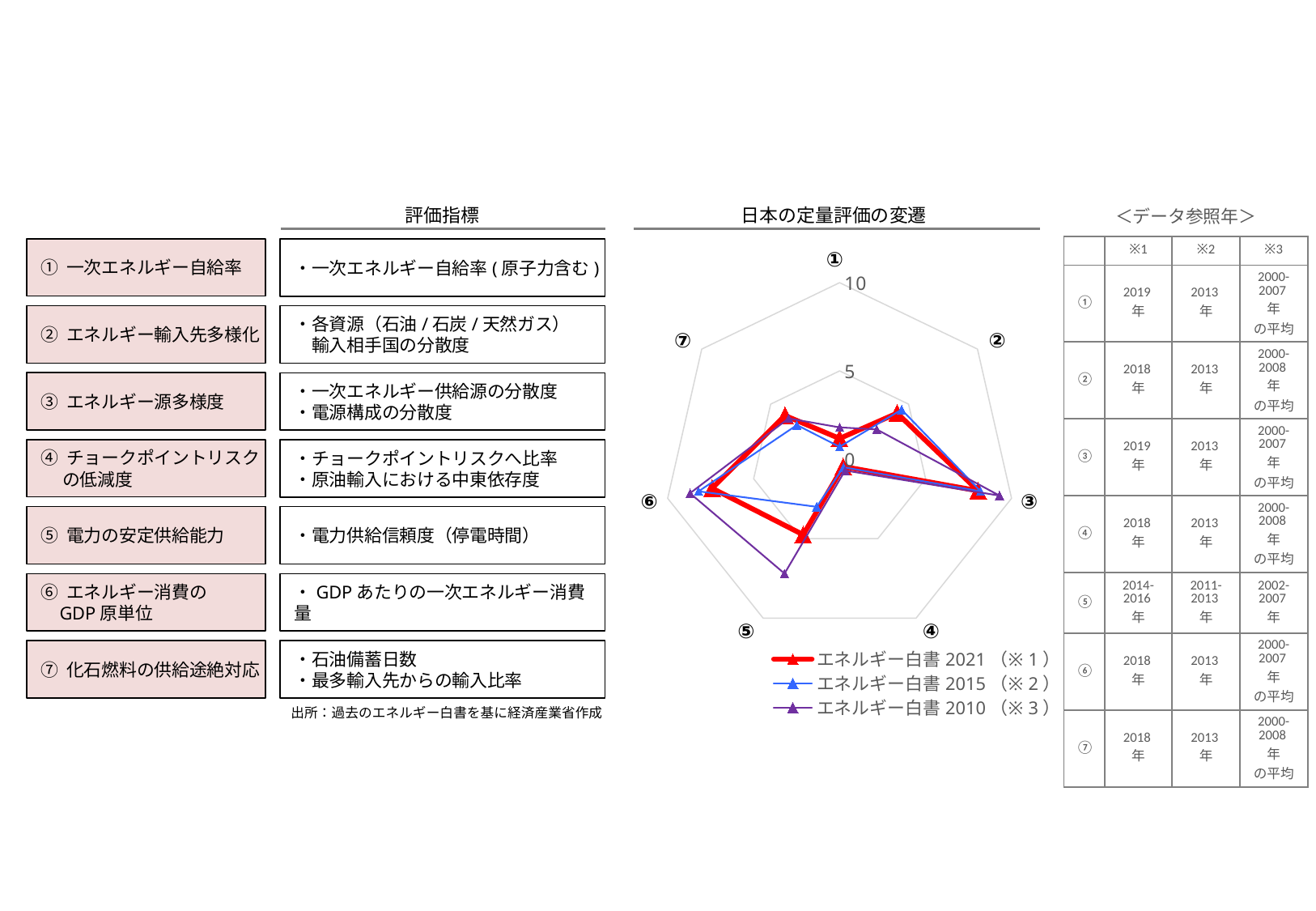
In the radar chart, is the value of エネルギー白書2010 on axis ⑤ greater or less than 5? greater How many axes (categories) does the radar chart have? 7 In the radar chart, is the value of エネルギー白書2021 on axis ③ greater or less than 5? greater In the radar chart, is the value of エネルギー白書2021 on axis ① greater or less than 5? less What kind of chart is shown under the title 日本の定量評価の変遷? Radar chart What is the title of the radar chart? 日本の定量評価の変遷 In the radar chart, on which axis does エネルギー白書2021 have its lowest value? ④ Which series in the radar chart is drawn in red? エネルギー白書2021（※1） In the radar chart, on axis ⑤, which series has the larger value: エネルギー白書2010 or エネルギー白書2021? エネルギー白書2010 How many series does the legend of the radar chart list? 3